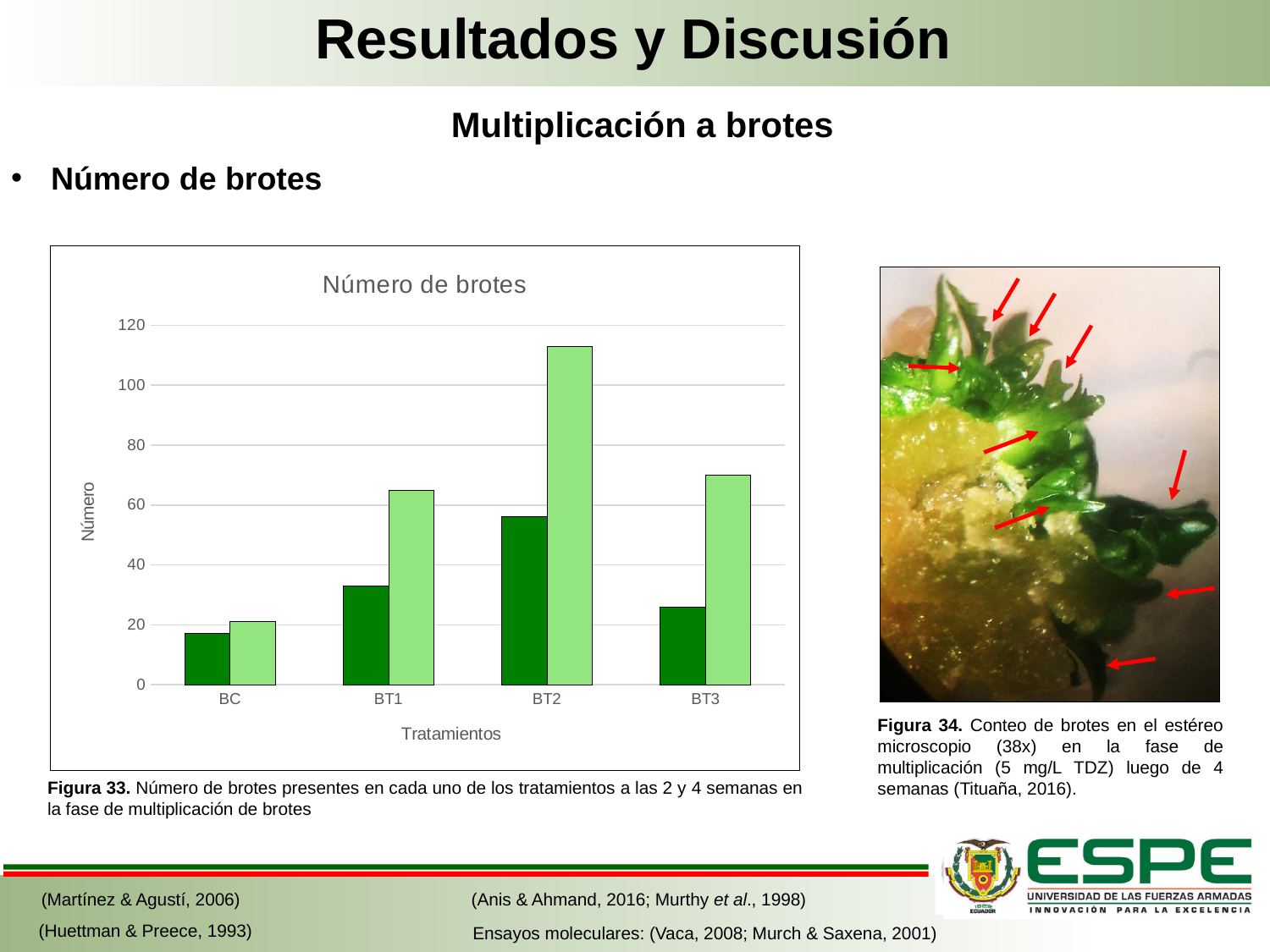
Which treatment has the shortest bars in the 'Número de brotes' chart? BC Which treatment has the tallest bar in the 'Número de brotes' chart? BT2 For each treatment in the 'Número de brotes' chart, which bar is taller: the dark green or the light green one? light green Is the light green bar for BT2 greater or less than 100? greater What kind of chart is shown in Figura 33? bar chart What is the title of the chart in Figura 33? Número de brotes What is the label of the x axis of the 'Número de brotes' chart? Tratamientos Which is larger in the 'Número de brotes' chart: the light green bar for BT3 or the light green bar for BT1? BT3 Is the light green bar for BT1 greater or less than 60? greater Is the dark green bar for BC greater or less than 20? less How many treatment categories are shown on the x axis of the 'Número de brotes' chart? 4